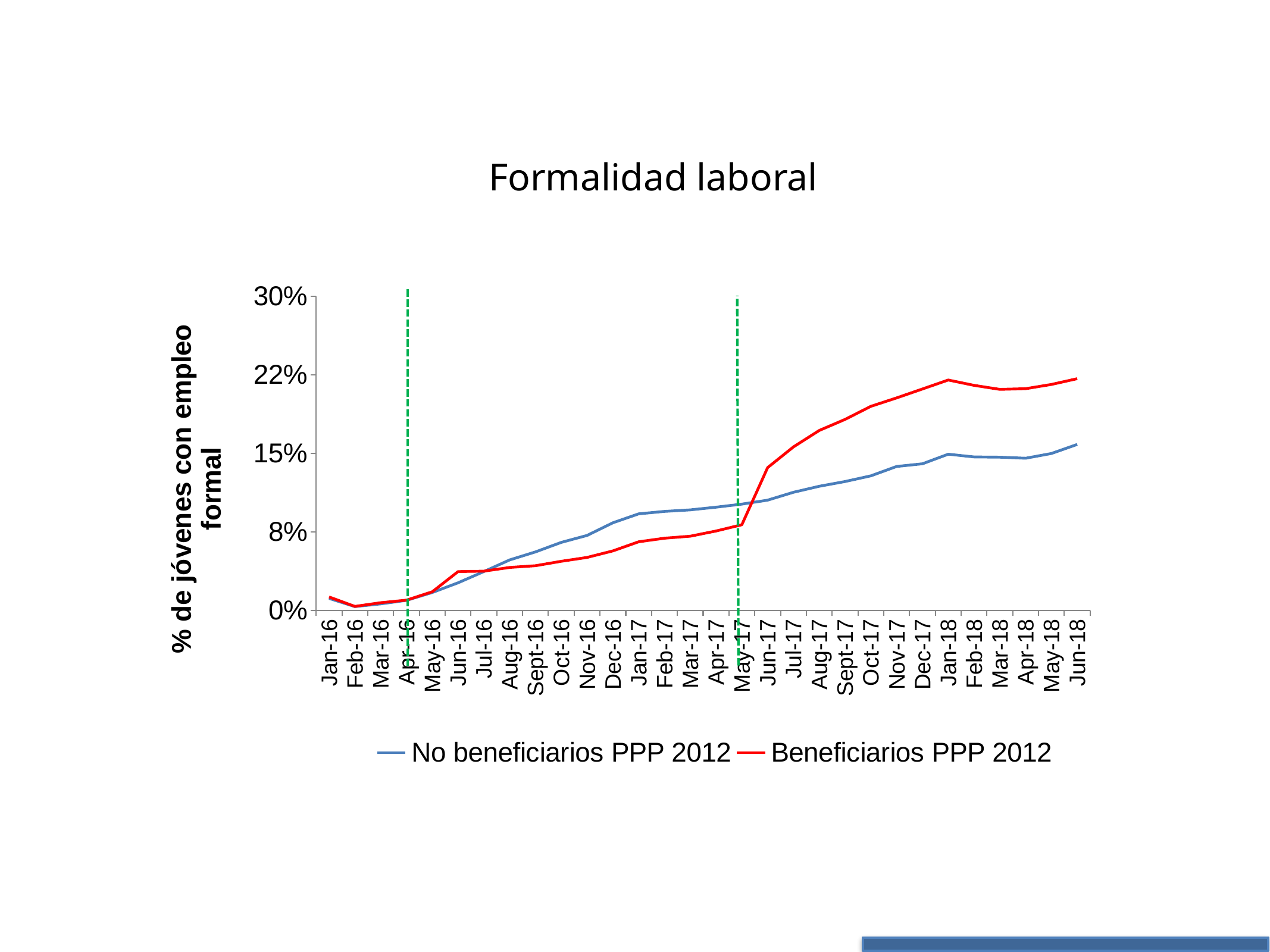
Which series is drawn in red? Beneficiarios PPP 2012 How many series does the legend list? 2 What kind of chart is shown on the slide? line chart Is the value for No beneficiarios PPP 2012 in Jun-17 greater or less than 15%? less In Jan-17, which series has the higher value, No beneficiarios PPP 2012 or Beneficiarios PPP 2012? No beneficiarios PPP 2012 Is the value for Beneficiarios PPP 2012 in Jun-18 greater or less than 15%? greater In Jun-18, which series has the higher value, No beneficiarios PPP 2012 or Beneficiarios PPP 2012? Beneficiarios PPP 2012 How many months are plotted along the x axis? 30 Is the value for No beneficiarios PPP 2012 in Jan-17 greater or less than 8%? greater Do the values for Beneficiarios PPP 2012 generally rise or fall from Jan-16 to Jun-18? rise What is the title of the chart? Formalidad laboral